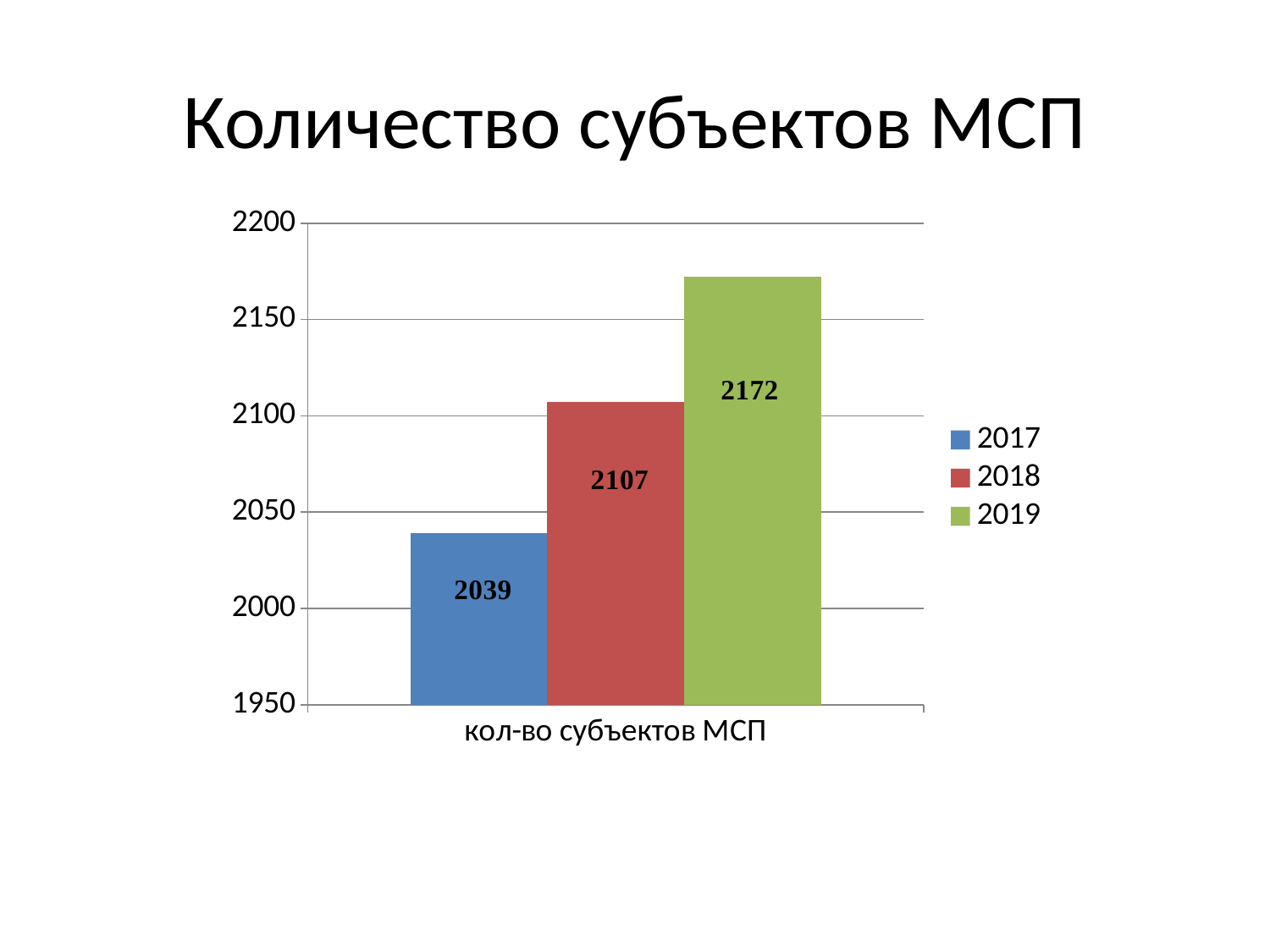
What is the value for 2018? 2107 What is the difference between the values for 2019 and 2017? 133 How many series does the legend list? 3 Is the value for 2017 greater or less than 2050? less Which year has the highest value? 2019 What is the value for 2017? 2039 What kind of chart is shown on the slide? bar chart What is the value for 2019? 2172 Which is larger, the value for 2018 or the value for 2019? 2019 What is the difference between the values for 2018 and 2017? 68 What is the title of the chart? Количество субъектов МСП Which year has the lowest value? 2017